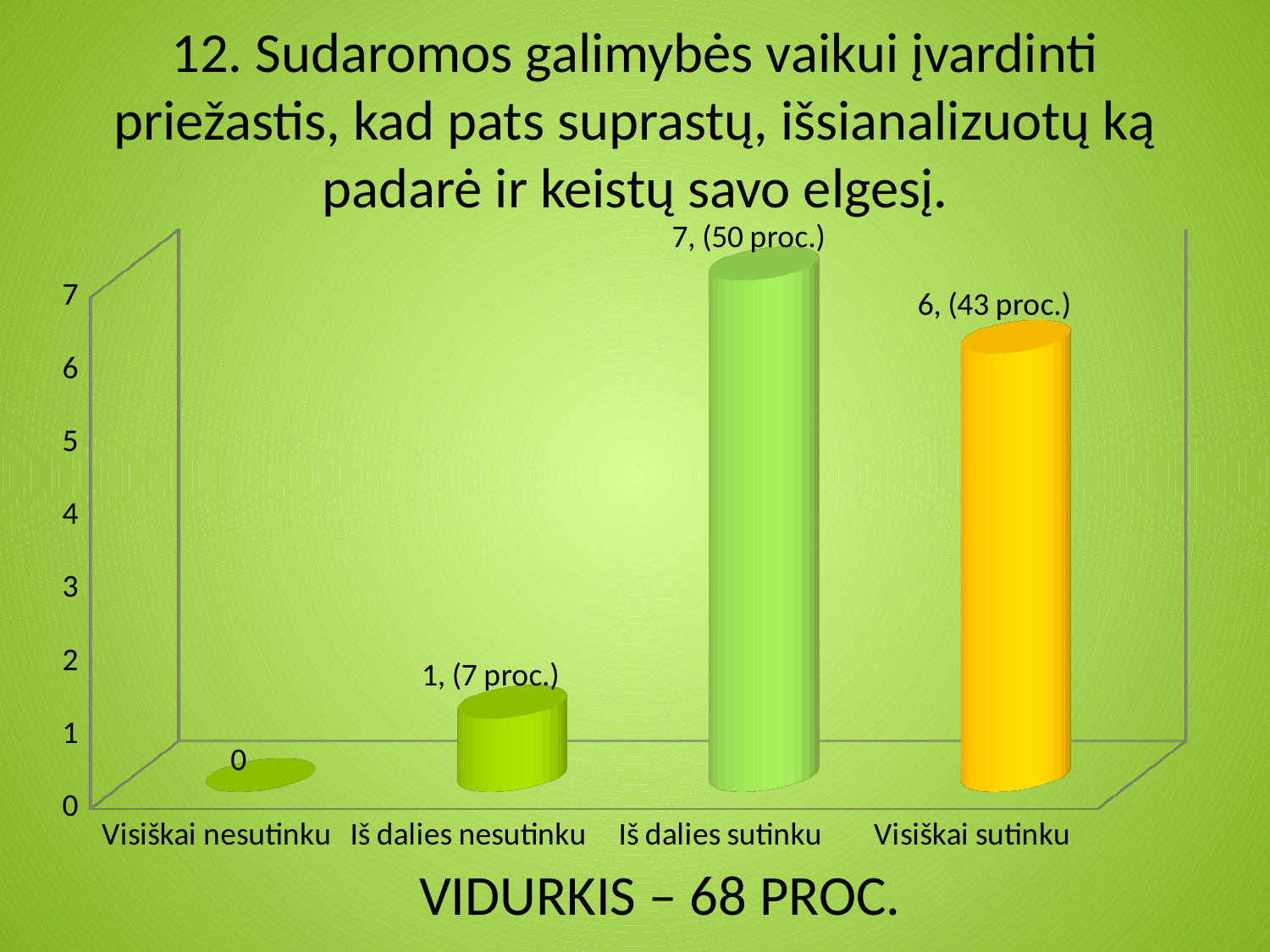
What kind of chart is shown on the slide? bar chart What is the difference in count between 'Iš dalies sutinku' and 'Visiškai sutinku'? 1 What average (VIDURKIS) is stated below the chart? 68 PROC. What is the value for 'Iš dalies sutinku'? 7, (50 proc.) Which category has the lowest value? Visiškai nesutinku What is the value for 'Iš dalies nesutinku'? 1, (7 proc.) What is the value for 'Visiškai sutinku'? 6, (43 proc.) Which category has the highest value? Iš dalies sutinku What is the value for 'Visiškai nesutinku'? 0 Which is larger, the value for 'Iš dalies nesutinku' or the value for 'Visiškai sutinku'? Visiškai sutinku How many categories are shown on the x axis? 4 What is the difference in count between 'Visiškai sutinku' and 'Iš dalies nesutinku'? 5